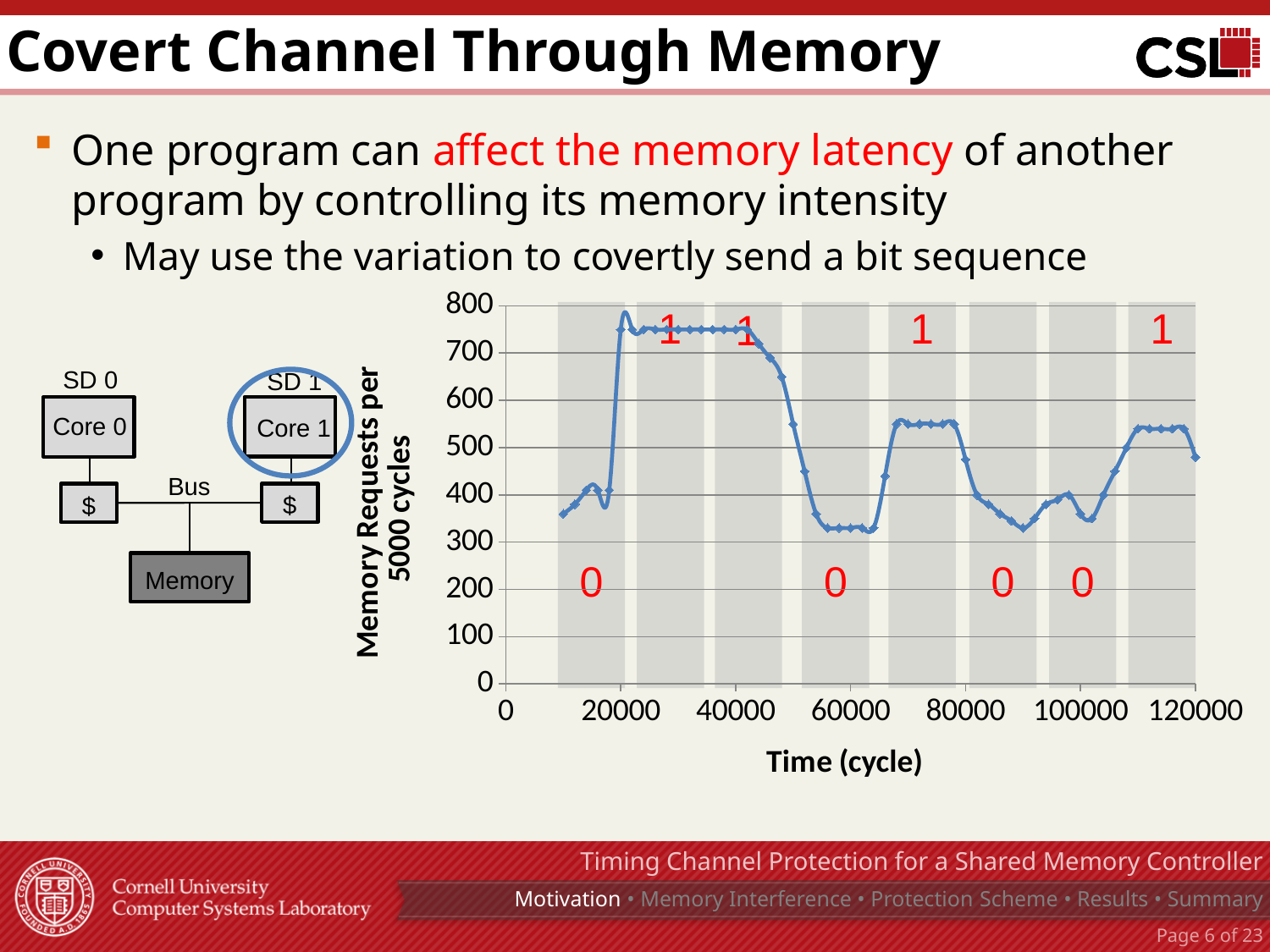
What is the highest tick value shown on the y-axis of the chart? 800 Is the value of memory requests at time 30000 greater or less than 700? greater Which is larger, the memory requests value at time 30000 or at time 60000? at time 30000 Is the value of memory requests at time 20000 greater or less than 700? greater What is the title of the y-axis of the chart? Memory Requests per 5000 cycles Is the value of memory requests at time 60000 greater or less than 400? less What is the title of the x-axis of the chart? Time (cycle) What kind of chart is shown on the slide? line chart How many red '1' labels are annotated on the chart? 4 How many red bit labels (0s and 1s) are annotated on the chart in total? 8